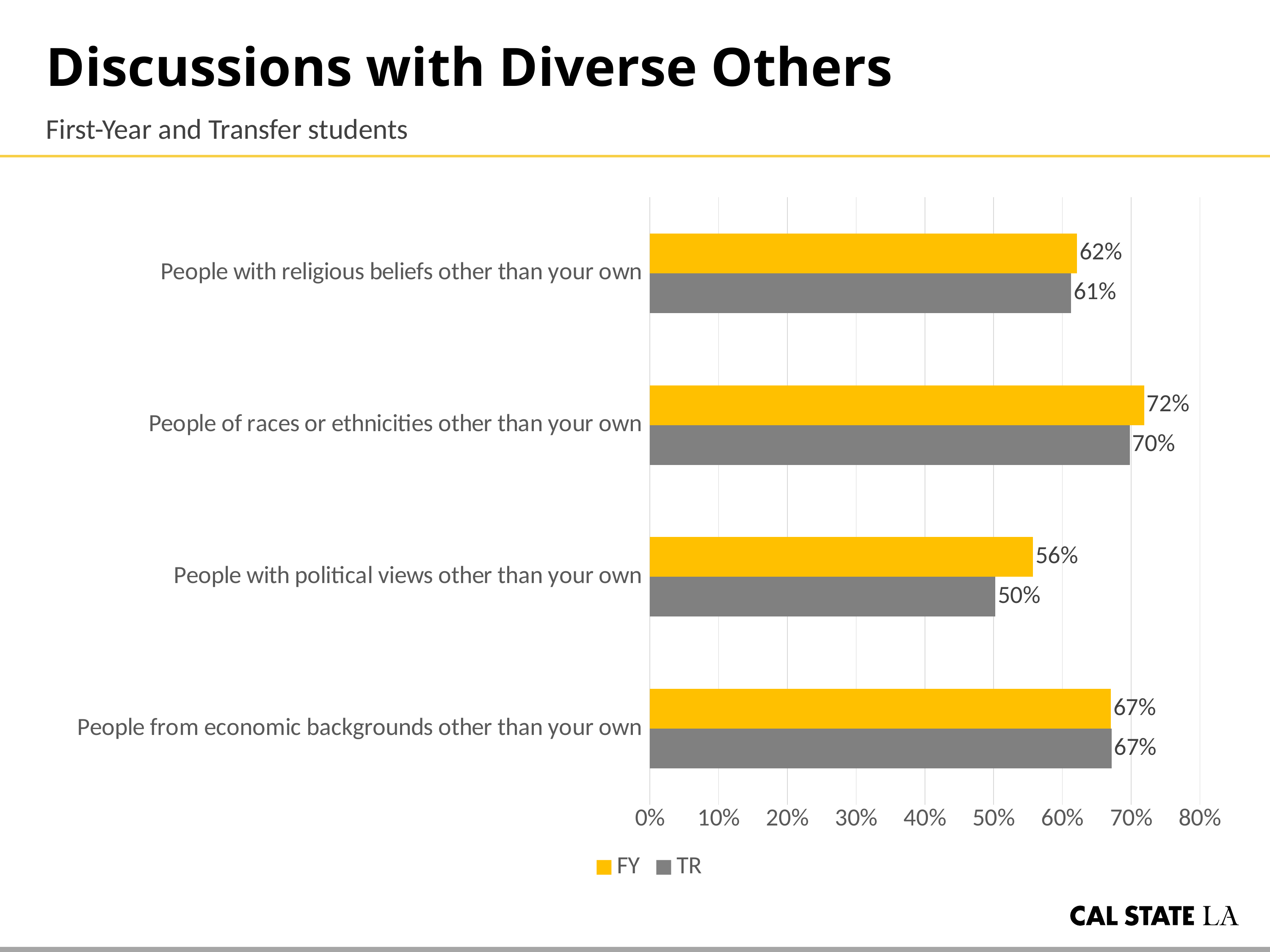
Is the TR value for People with religious beliefs other than your own greater or less than 50%? greater What is the difference between the FY and TR values for People with political views other than your own? 6% What kind of chart is shown on the slide? bar chart How many categories are shown on the chart? 4 Which category has the lowest TR value? People with political views other than your own Which category has the highest FY value? People of races or ethnicities other than your own Which colour represents the TR series in the chart? gray Which is larger for People of races or ethnicities other than your own, the FY value or the TR value? FY What is the TR value for People with political views other than your own? 50% How many series does the legend list? 2 What is the TR value for People of races or ethnicities other than your own? 70% What is the FY value for People with religious beliefs other than your own? 62%